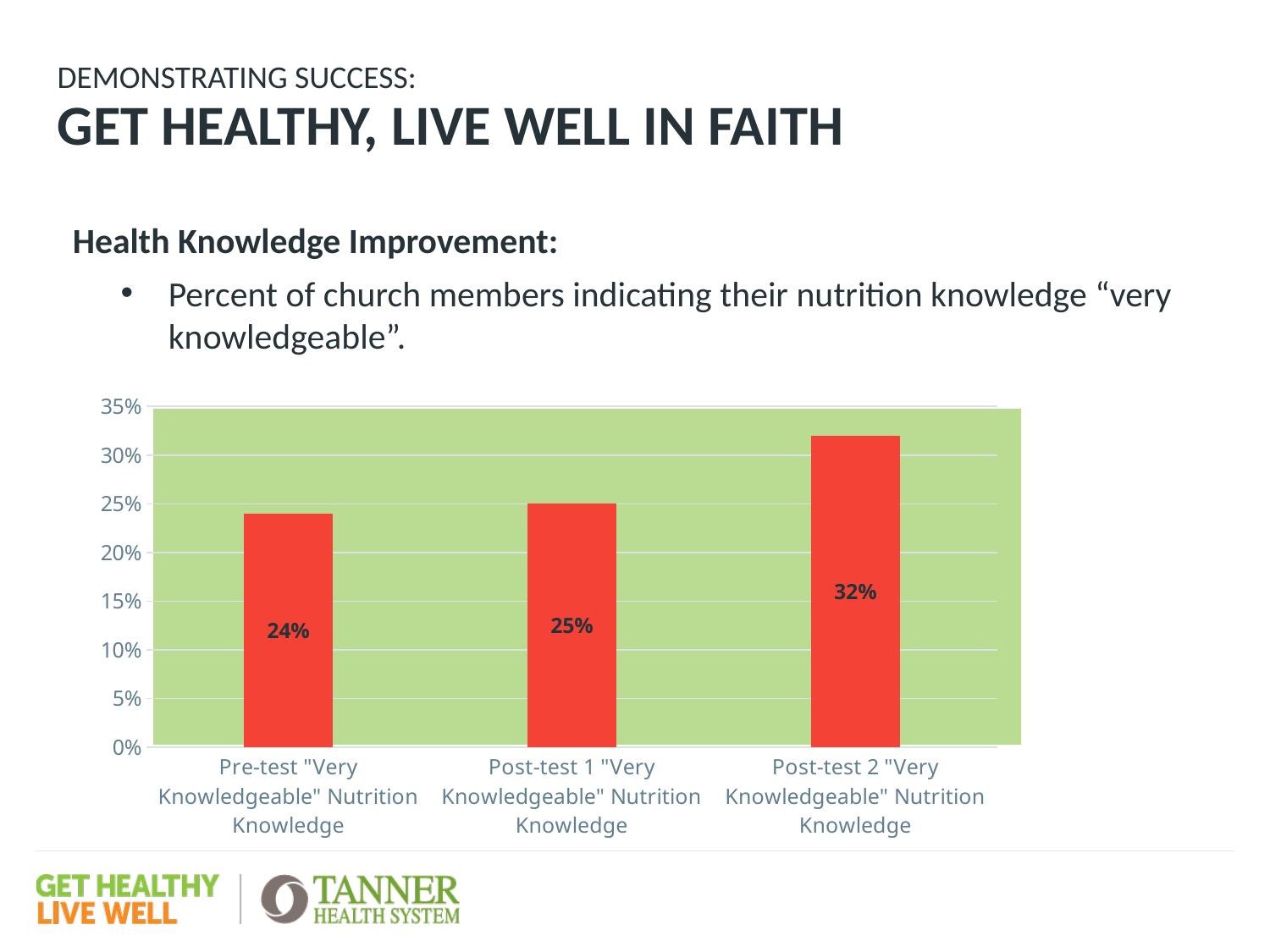
What is the difference between the Post-test 2 value and the Pre-test value? 8% What kind of chart is shown on the slide? bar chart What is the value for Pre-test "Very Knowledgeable" Nutrition Knowledge? 24% Do the values rise or fall from Pre-test to Post-test 2? rise What is the value for Post-test 1 "Very Knowledgeable" Nutrition Knowledge? 25% Is the value for Post-test 2 greater or less than 30%? greater What is the value for Post-test 2 "Very Knowledgeable" Nutrition Knowledge? 32% What is the difference between the Post-test 2 value and the Post-test 1 value? 7% How many categories are shown in the chart? 3 Which is larger, the value for Post-test 2 or the value for Pre-test? Post-test 2 Which category has the highest value? Post-test 2 "Very Knowledgeable" Nutrition Knowledge Which category has the lowest value? Pre-test "Very Knowledgeable" Nutrition Knowledge